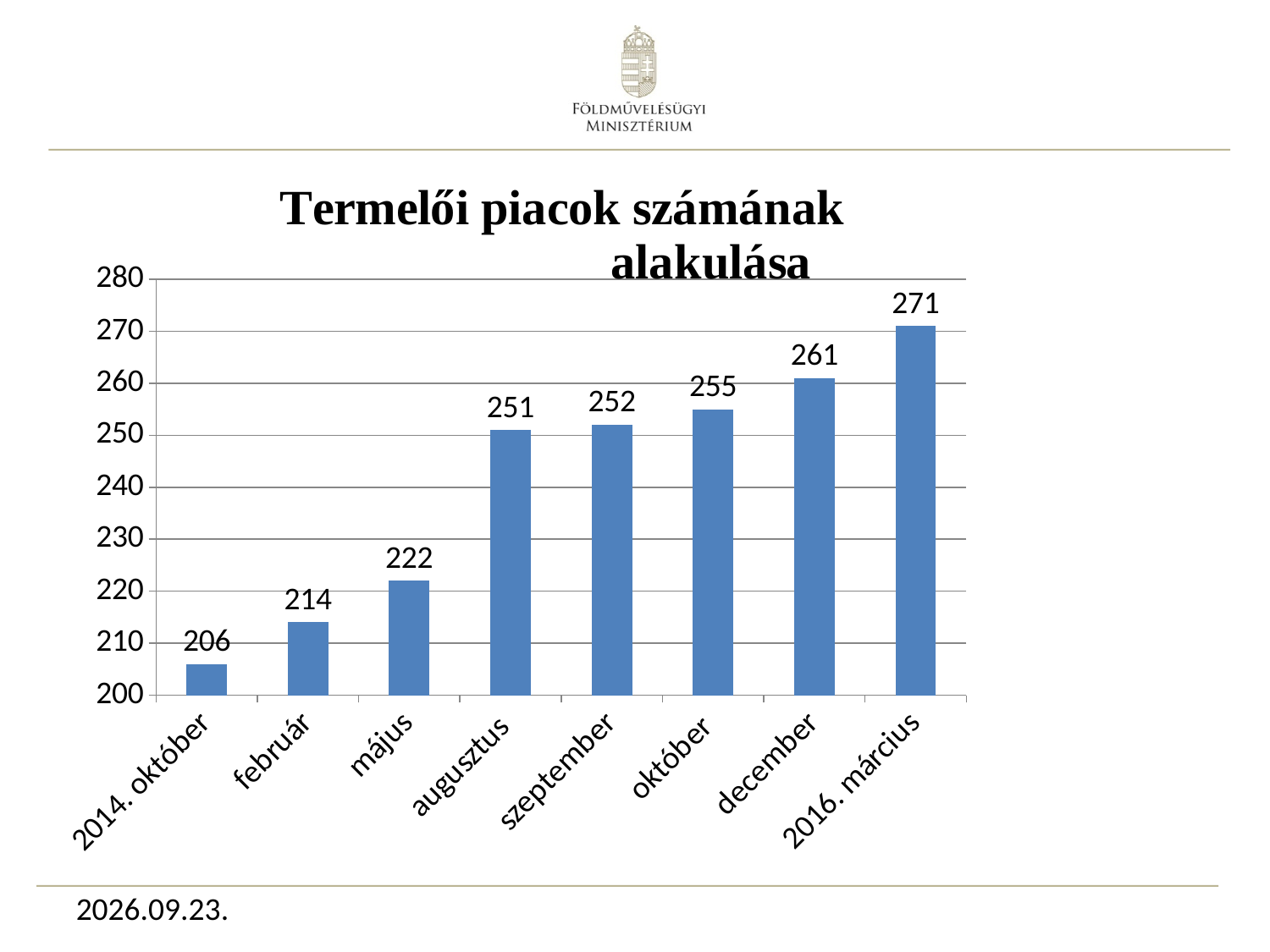
How many categories are shown on the x axis? 8 Which is larger, the value for október or the value for szeptember? október What is the value for augusztus? 251 Which category has the highest value? 2016. március What kind of chart is this? bar chart Is the value for május greater or less than 230? less Do the values rise or fall from left to right along the x axis? rise Which category has the lowest value? 2014. október What is the value for 2014. október? 206 What is the difference between the values for május and február? 8 What is the value for december? 261 What is the difference between the values for 2016. március and 2014. október? 65